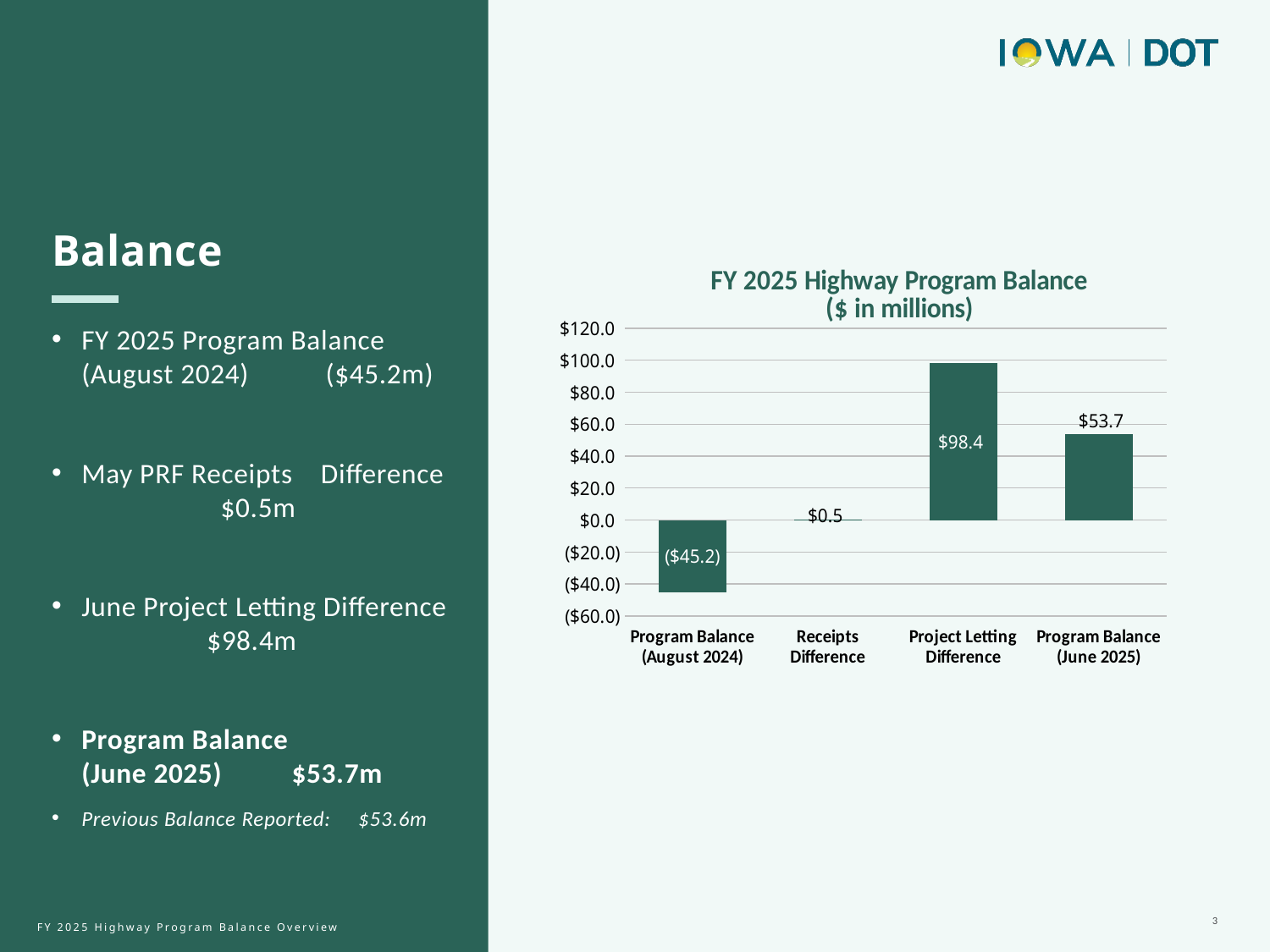
What is the value for Receipts Difference in the chart? $0.5 How many categories are shown on the x axis of the chart? 4 Is the value for Project Letting Difference greater or less than $80.0? greater Which is larger, Program Balance (June 2025) or Receipts Difference? Program Balance (June 2025) What is the title of the chart? FY 2025 Highway Program Balance ($ in millions) Which category has the highest value in the chart? Project Letting Difference What is the value for Project Letting Difference in the chart? $98.4 What is the difference between Project Letting Difference and Program Balance (June 2025)? $44.7 What is the value for Program Balance (June 2025) in the chart? $53.7 What kind of chart is shown on the slide? bar chart Which category has the lowest value in the chart? Program Balance (August 2024) What is the value for Program Balance (August 2024) in the FY 2025 Highway Program Balance chart? ($45.2)